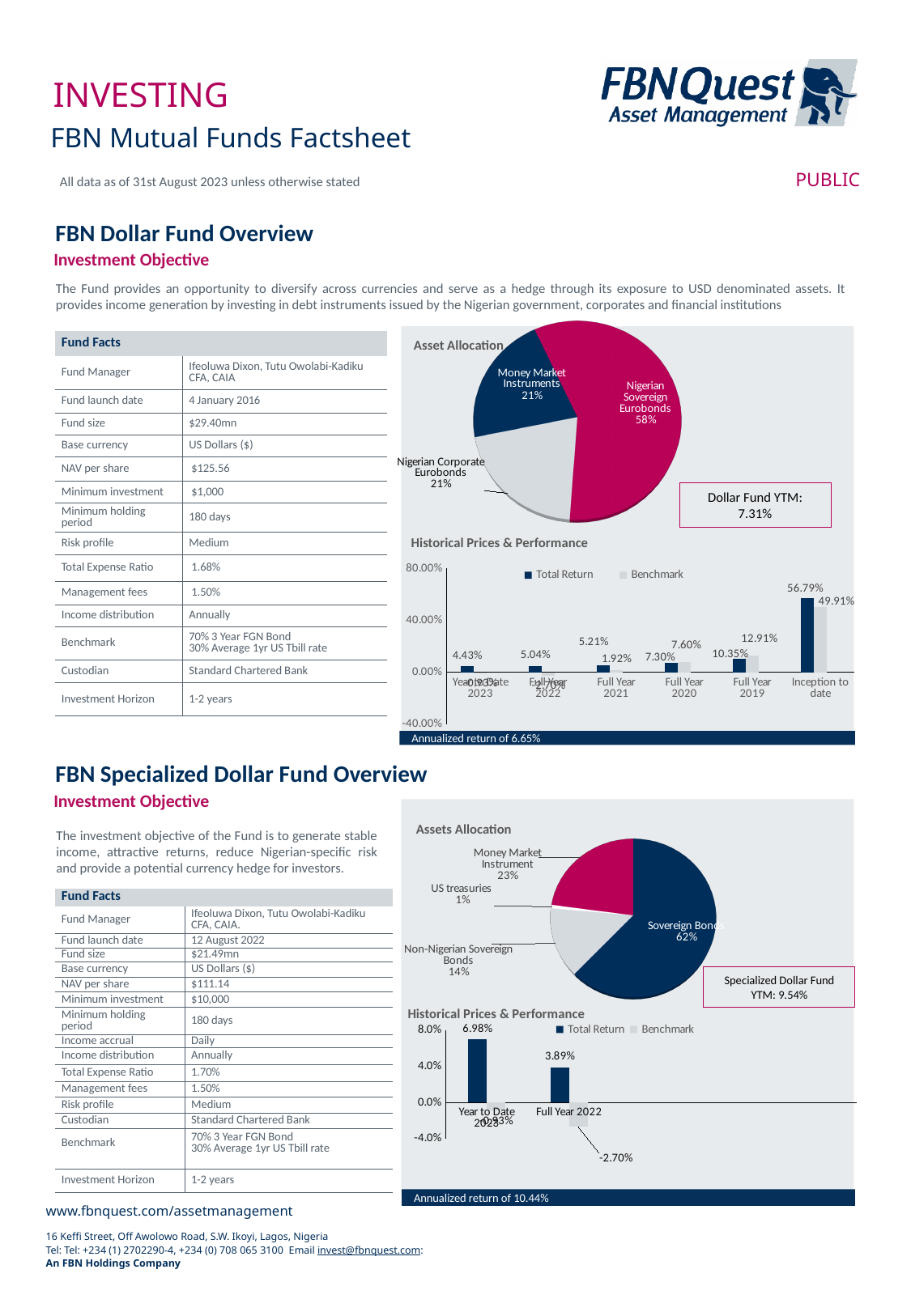
What type of chart is the FBN Dollar Fund Historical Prices & Performance chart? Bar chart How many slices does the FBN Dollar Fund Asset Allocation pie chart have? 3 In the FBN Dollar Fund Asset Allocation pie chart, which category has the largest share? Nigerian Sovereign Eurobonds In the FBN Dollar Fund Historical Prices & Performance chart, what is the Total Return for Inception to date? 56.79% How many series does the legend of the FBN Dollar Fund Historical Prices & Performance chart list? 2 In the FBN Specialized Dollar Fund Assets Allocation pie chart, which category has the smallest share? US treasuries In the FBN Specialized Dollar Fund Historical Prices & Performance chart, what is the Total Return for Year to Date 2023? 6.98% In the FBN Dollar Fund Historical Prices & Performance chart, what is the Benchmark value for Full Year 2019? 12.91% In the FBN Dollar Fund Historical Prices & Performance chart, which is larger for Full Year 2021, Total Return or Benchmark? Total Return In the FBN Dollar Fund Asset Allocation pie chart, what share is Nigerian Sovereign Eurobonds? 58% In the FBN Specialized Dollar Fund Assets Allocation pie chart, what share is Non-Nigerian Sovereign Bonds? 14% In the FBN Dollar Fund Historical Prices & Performance chart, what is the difference between Total Return and Benchmark for Inception to date? 6.88%